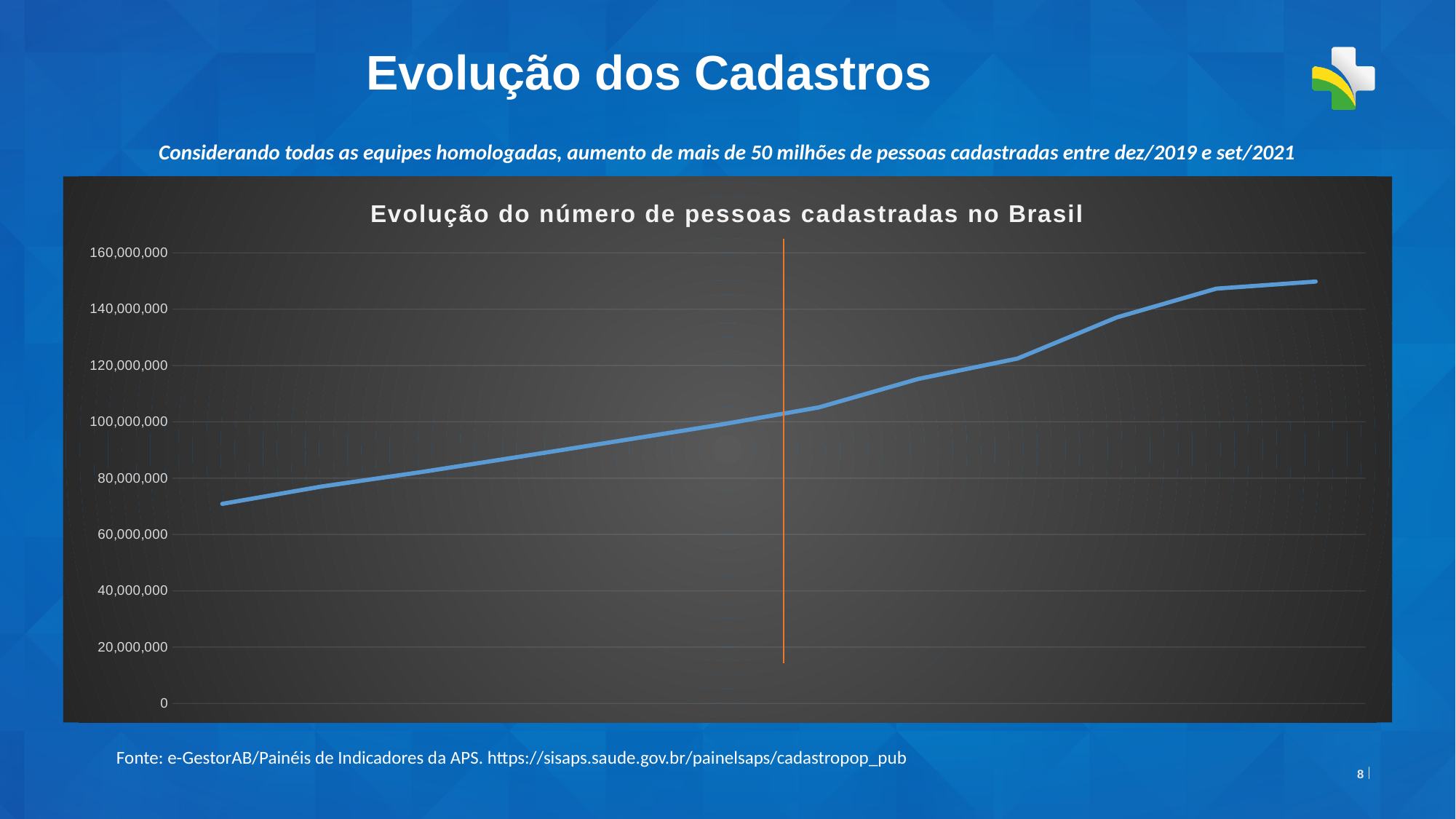
Is the value at the rightmost point of the line greater or less than 140,000,000? greater Do the values rise or fall from left to right along the x axis? rise What is the title of the chart? Evolução do número de pessoas cadastradas no Brasil Which end of the line, leftmost or rightmost, has the higher value? rightmost What is the highest value labelled on the vertical axis? 160,000,000 Is the value at the leftmost point of the line greater or less than 80,000,000? less Is the value at the leftmost point of the line greater or less than 60,000,000? greater What kind of chart is shown on the slide? line chart